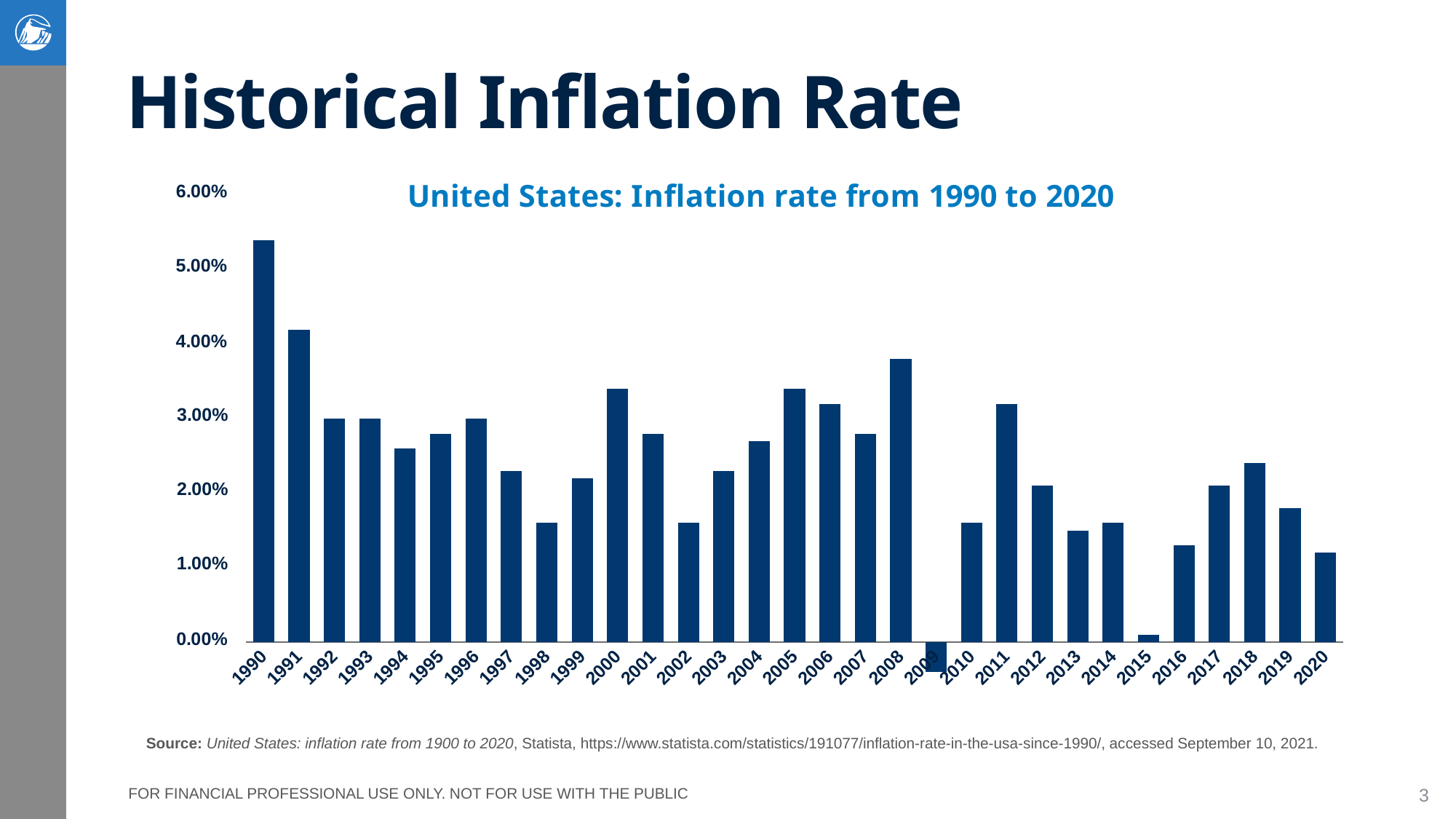
What kind of chart is shown on the slide? bar chart Which year has the lowest inflation rate in the chart? 2009 Overall, does the inflation rate rise or fall from 1990 to 2020? fall Which year has the higher inflation rate, 1990 or 2020? 1990 Is the inflation rate for 2015 greater or less than 1.00%? less Is the inflation rate for 2009 greater or less than 0.00%? less Is the inflation rate for 1990 greater or less than 5.00%? greater Which year has the highest inflation rate in the chart? 1990 How many years (bars) are plotted in the chart? 31 Which year has the higher inflation rate, 2007 or 2008? 2008 What is the title of the chart? United States: Inflation rate from 1990 to 2020